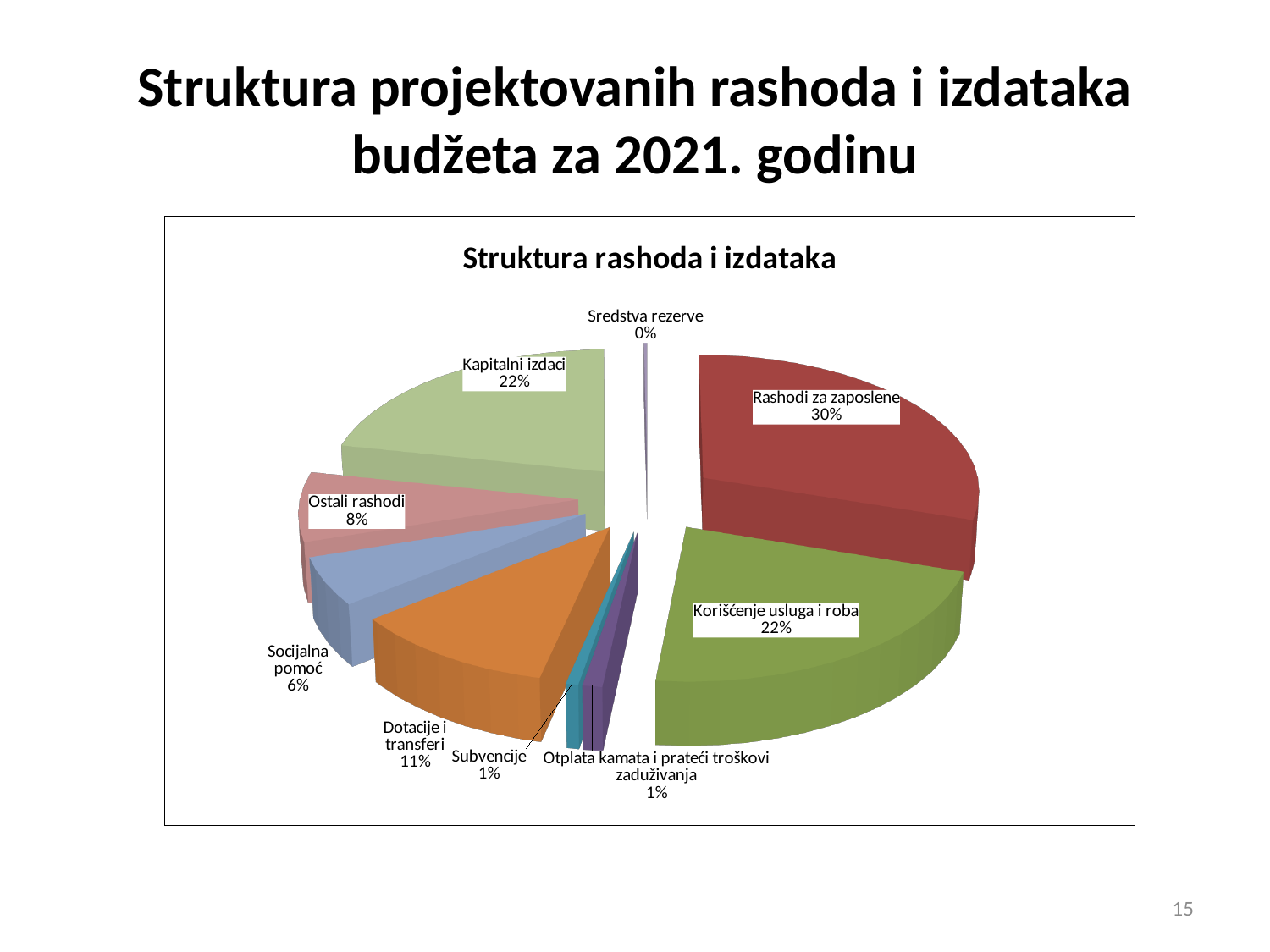
What is the difference in percentage points between Rashodi za zaposlene and Kapitalni izdaci? 8 percentage points How many categories (slices) does the pie chart have? 9 Which category has the largest share of the pie? Rashodi za zaposlene Which category has the smallest share of the pie? Sredstva rezerve What percentage is shown for Sredstva rezerve? 0% What share of the pie does Rashodi za zaposlene represent? 30% What is the title of the chart? Struktura rashoda i izdataka What percentage is shown for Dotacije i transferi? 11% What percentage is shown for Socijalna pomoć? 6% What kind of chart is shown on the slide? pie chart Which is larger, the share for Dotacije i transferi or the share for Ostali rashodi? Dotacije i transferi What percentage is shown for Ostali rashodi? 8%